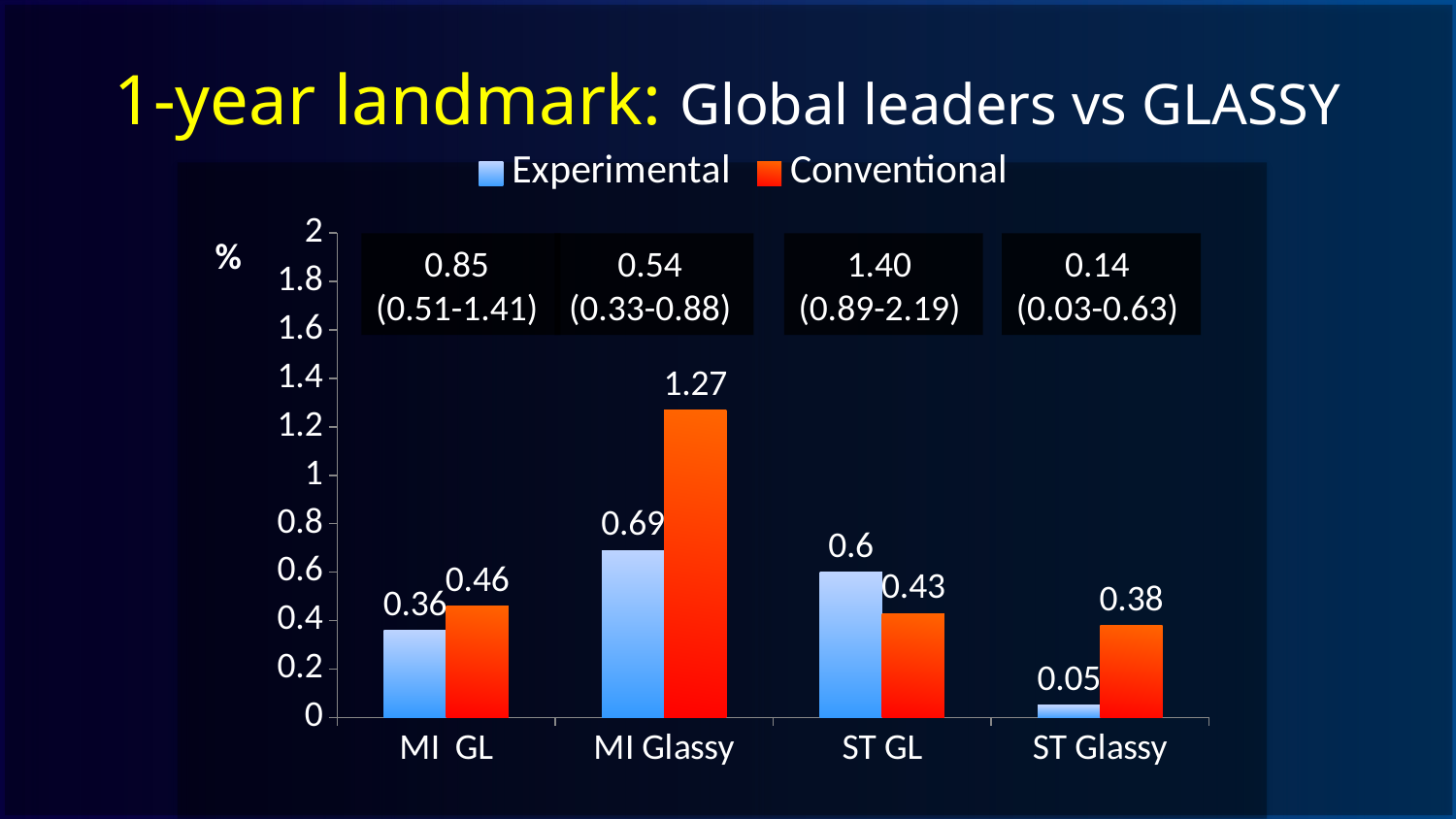
Is the Conventional value for MI Glassy greater or less than 1? greater Which category has the highest Conventional value? MI Glassy What kind of chart is shown on the slide? bar chart For ST GL, which series has the larger value, Experimental or Conventional? Experimental How many categories are shown on the x axis? 4 What colour represents the Conventional series? red What is the Experimental value for ST GL? 0.6 What is the Experimental value for MI Glassy? 0.69 How many series does the legend list? 2 What is the difference between the Conventional and Experimental values for MI Glassy? 0.58 Which category has the lowest Experimental value? ST Glassy What is the Conventional value for ST Glassy? 0.38